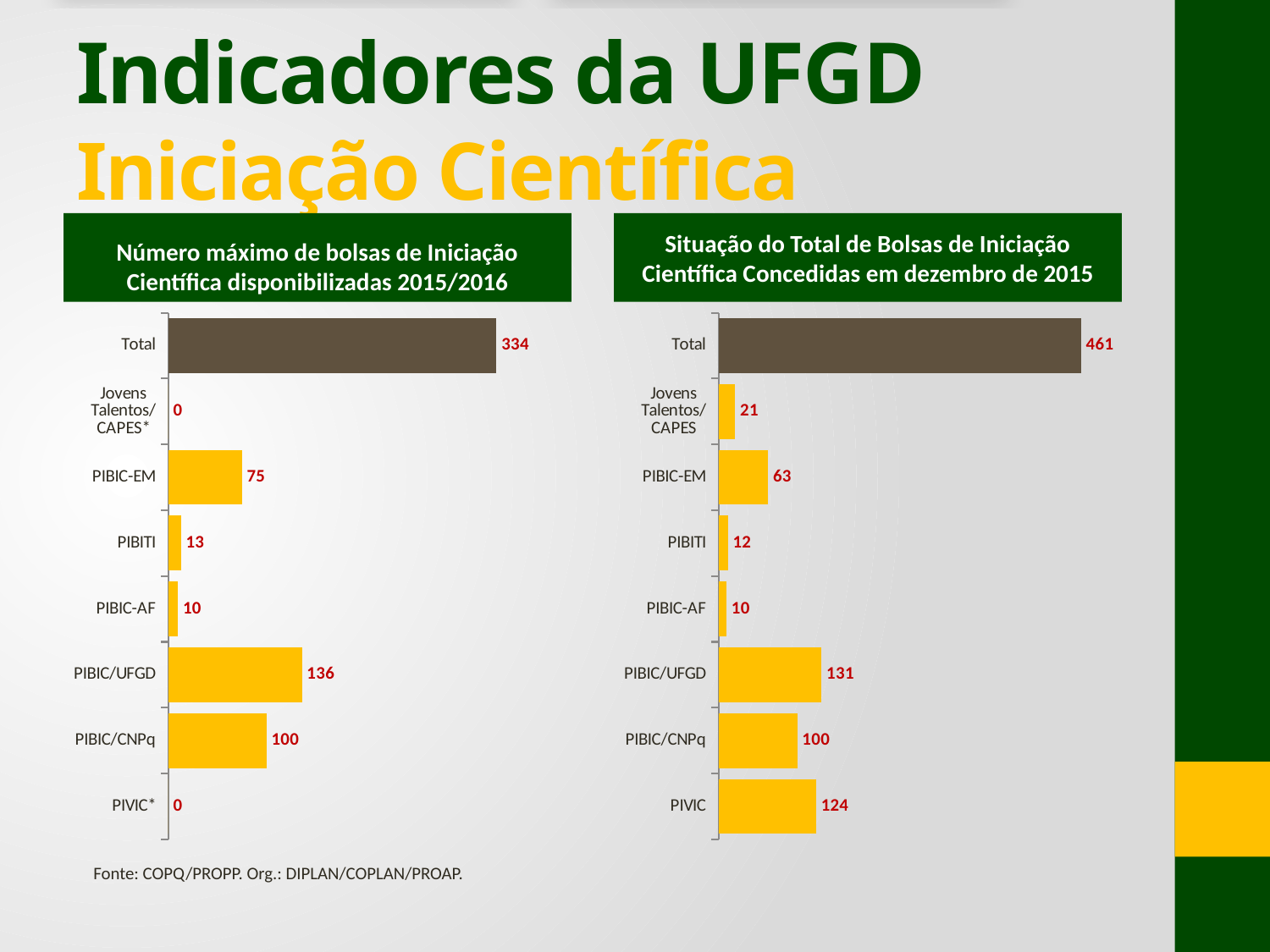
In the left chart (Número máximo de bolsas de Iniciação Científica disponibilizadas 2015/2016), what is the value for Total? 334 In the right chart (Situação do Total de Bolsas de Iniciação Científica Concedidas em dezembro de 2015), excluding Total, which program has the lowest value? PIBIC-AF In the left chart (Número máximo de bolsas de Iniciação Científica disponibilizadas 2015/2016), what is the value for PIBIC/UFGD? 136 In the left chart (Número máximo de bolsas de Iniciação Científica disponibilizadas 2015/2016), which is larger, PIBIC-EM or PIBIC/CNPq? PIBIC/CNPq In the right chart (Situação do Total de Bolsas de Iniciação Científica Concedidas em dezembro de 2015), what is the value for Jovens Talentos/CAPES? 21 What is the difference between the Total in the right chart (461) and the Total in the left chart (334)? 127 In the right chart (Situação do Total de Bolsas de Iniciação Científica Concedidas em dezembro de 2015), what is the value for PIVIC? 124 What is the source cited at the bottom of the slide? COPQ/PROPP. Org.: DIPLAN/COPLAN/PROAP. In the right chart (Situação do Total de Bolsas de Iniciação Científica Concedidas em dezembro de 2015), what is the difference between PIBIC/UFGD and PIBIC/CNPq? 31 How many categories (bars) are shown in the right chart (Situação do Total de Bolsas de Iniciação Científica Concedidas em dezembro de 2015)? 8 What type of chart is used on the left side of the slide? Bar chart In the left chart (Número máximo de bolsas de Iniciação Científica disponibilizadas 2015/2016), excluding Total, which program has the highest value? PIBIC/UFGD